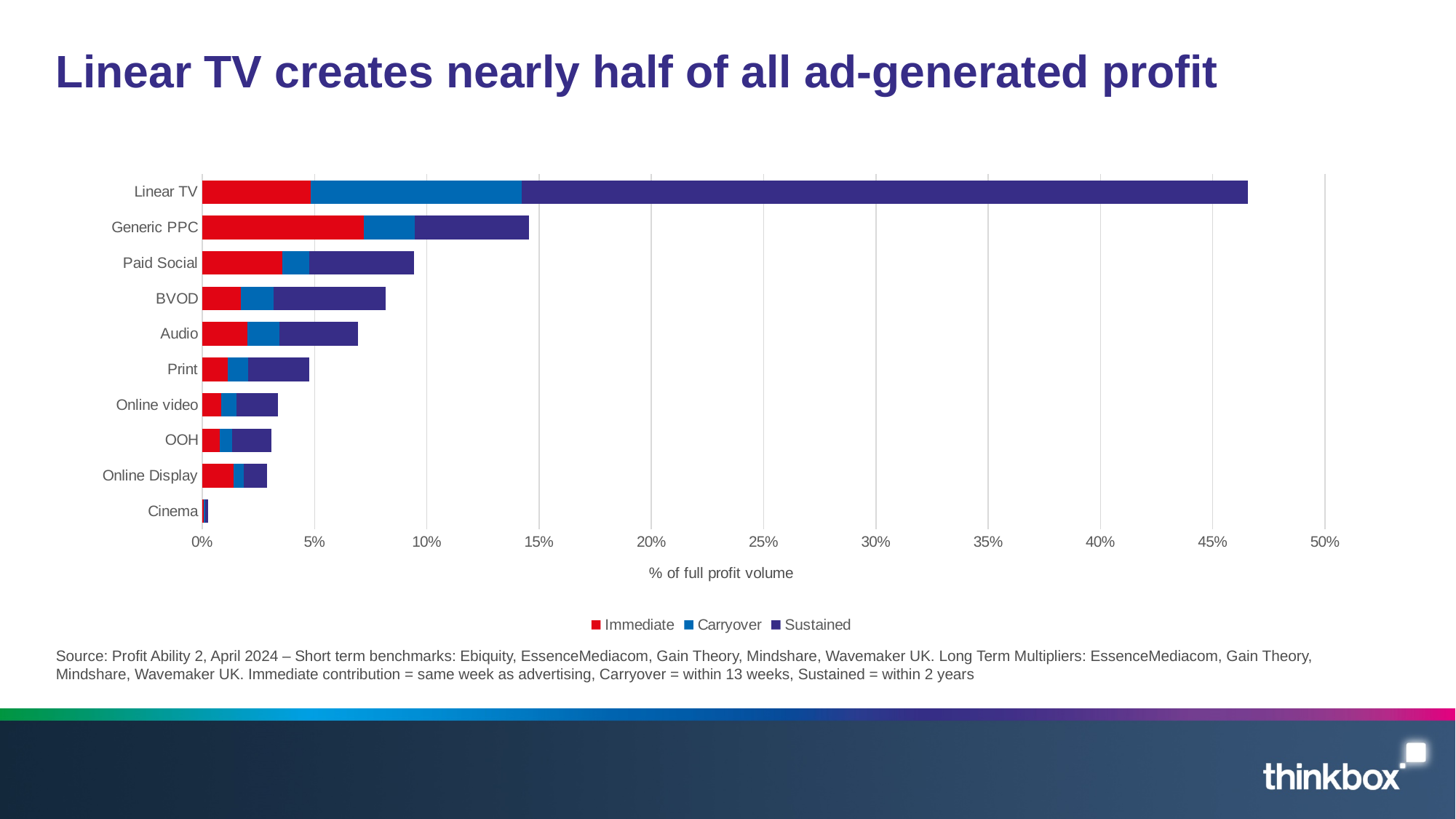
What is the label on the horizontal axis of the chart? % of full profit volume Which channel has the highest total share of full profit volume? Linear TV How many series does the legend list? 3 Is the total value for Generic PPC greater or less than 10%? greater Is the total value for Online video greater or less than 5%? less How many media channels (categories) are plotted on the chart? 10 Which channel has the lowest total share of full profit volume? Cinema Is the total value for Linear TV greater or less than 45%? greater What kind of chart is shown on the slide? Stacked bar chart Which series is shown in red in the legend? Immediate Which has a larger total bar, Audio or Print? Audio Which has a larger total bar, Generic PPC or Paid Social? Generic PPC